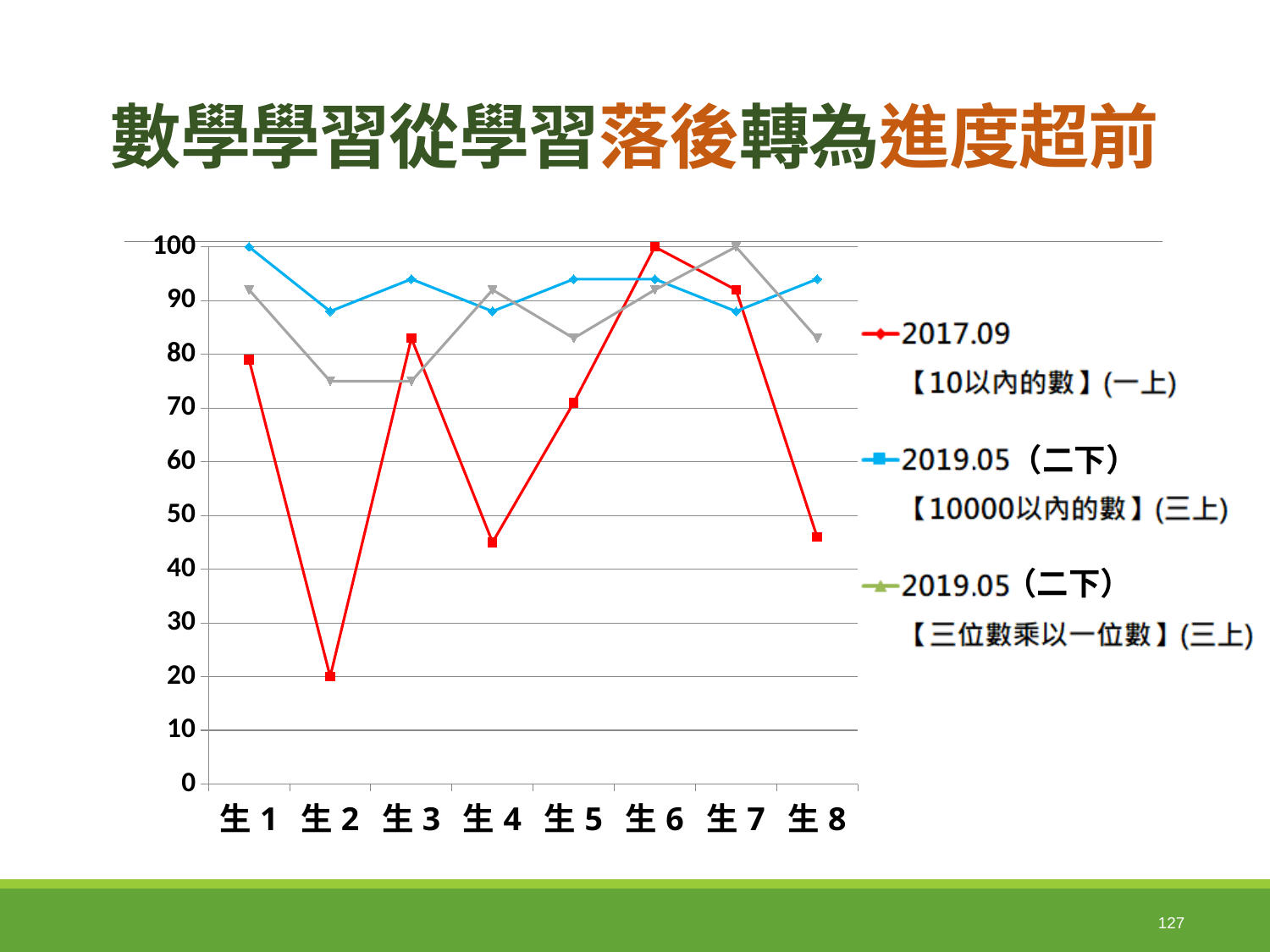
For 生 2, which series has the larger value: 2017.09【10以內的數】(一上) or 2019.05（二下）【10000以內的數】(三上)? 2019.05（二下）【10000以內的數】(三上) What is the value for 生 2 in the 2017.09【10以內的數】(一上) series? 20 Is the value for 生 4 in the 2017.09【10以內的數】(一上) series greater or less than 50? less Which student has the highest value in the 2017.09【10以內的數】(一上) series? 生 6 Which student has the lowest value in the 2017.09【10以內的數】(一上) series? 生 2 Is the value for 生 2 in the 2019.05（二下）【10000以內的數】(三上) series greater or less than 80? greater How many series does the legend list? 3 What kind of chart is shown on the slide? line chart How many students (categories) are shown on the x axis? 8 Which series is drawn in red? 2017.09【10以內的數】(一上) What is the value for 生 6 in the 2017.09【10以內的數】(一上) series? 100 Is the value for 生 1 in the 2017.09【10以內的數】(一上) series greater or less than 70? greater